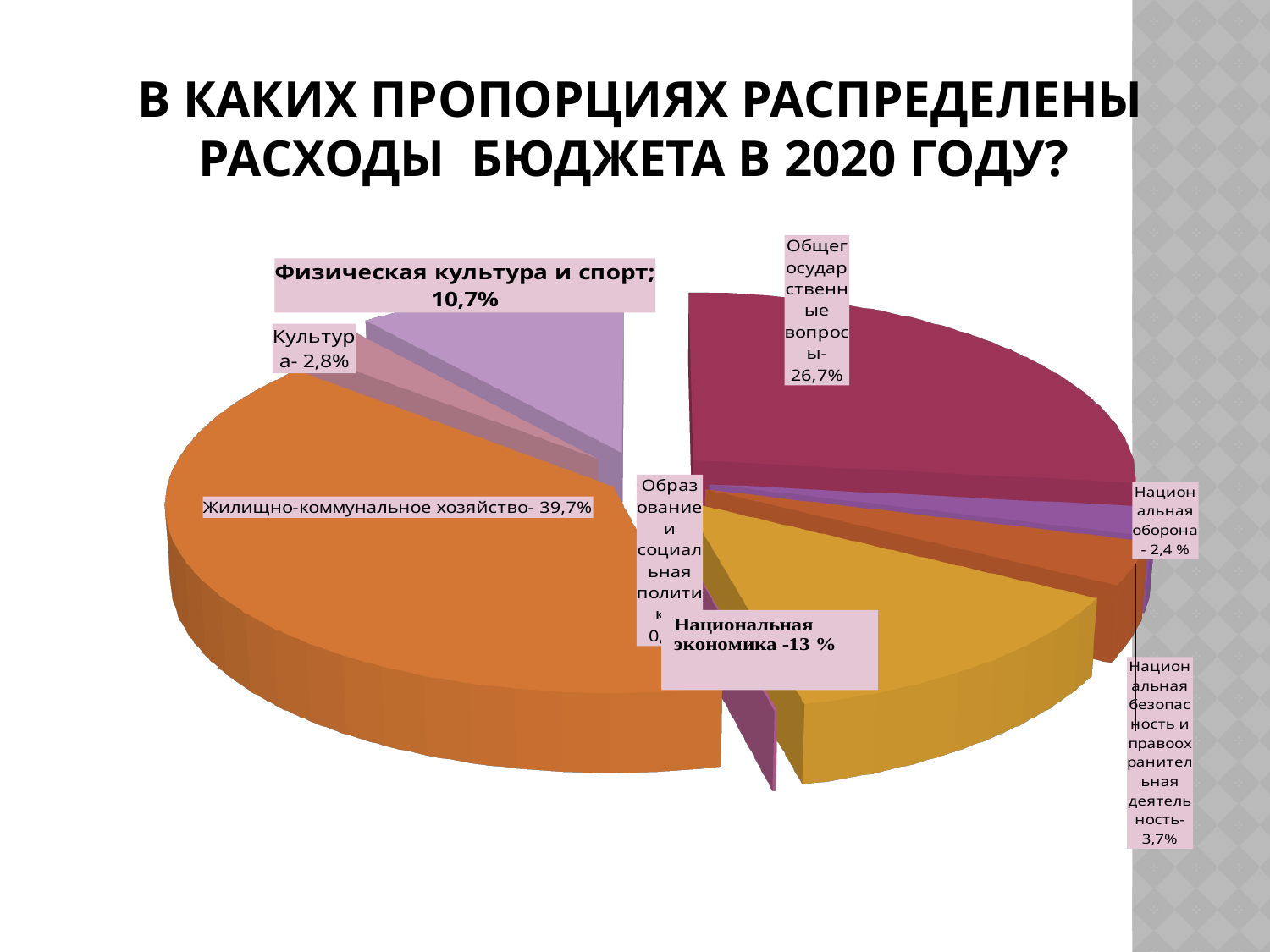
Which is larger: the share for Физическая культура и спорт or for Национальная экономика? Национальная экономика What share of the budget expenditure goes to Жилищно-коммунальное хозяйство? 39,7% What share is shown for Национальная безопасность и правоохранительная деятельность? 3,7% What kind of chart is shown on the slide? Pie chart What share is shown for Физическая культура и спорт? 10,7% What share is shown for Общегосударственные вопросы? 26,7% What is the title of the slide? В каких пропорциях распределены расходы бюджета в 2020 году? By how many percentage points does Жилищно-коммунальное хозяйство exceed Общегосударственные вопросы? 13 What share is shown for Национальная оборона? 2,4 % What share is shown for Национальная экономика? 13 % Which category has the largest share of the budget expenditure? Жилищно-коммунальное хозяйство What share is shown for Культура? 2,8%